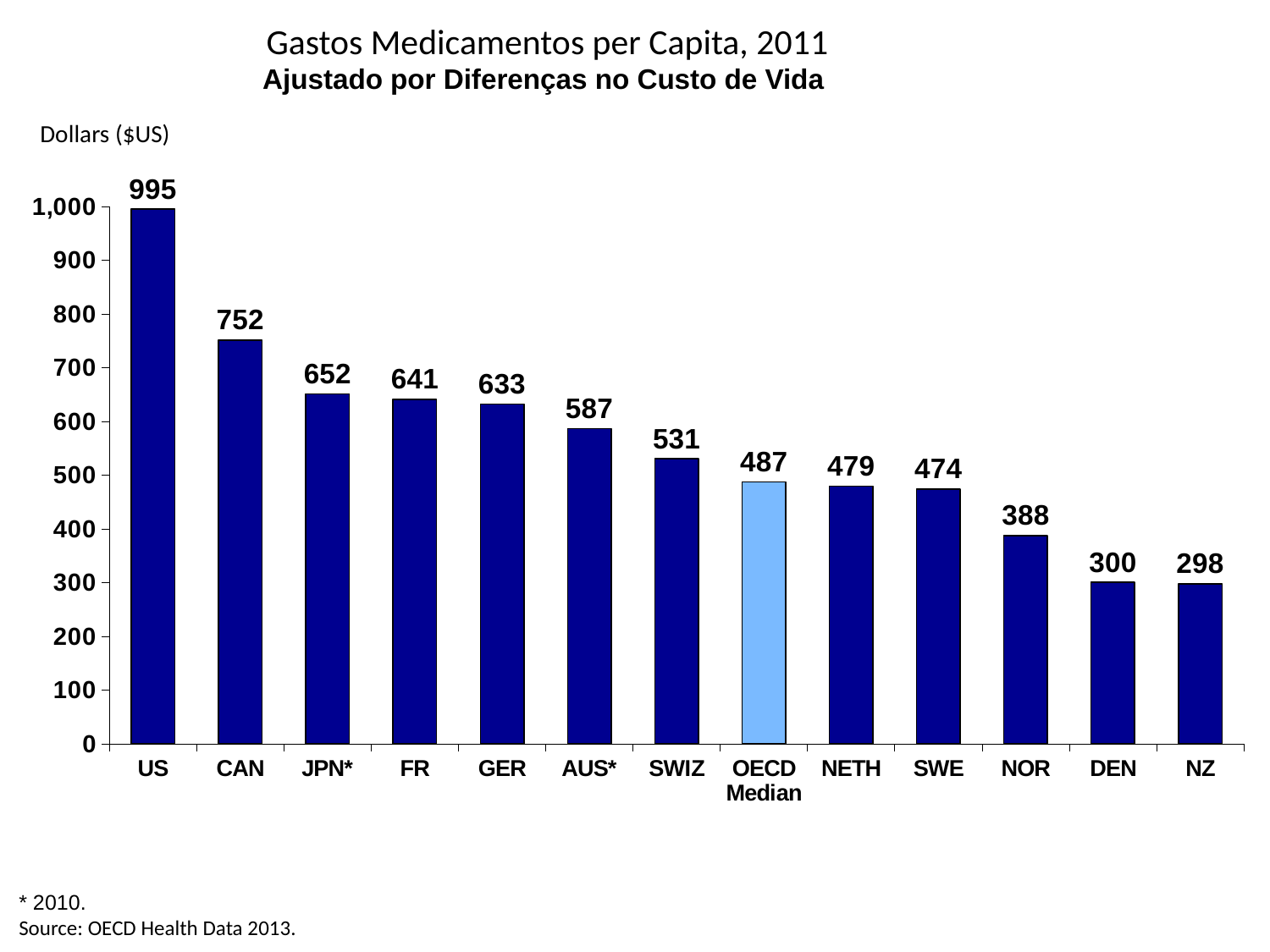
What is the value for NOR? 388 What is the difference between the values for SWIZ and the OECD Median? 44 What is the difference between the values for US and CAN? 243 What is the value for the OECD Median? 487 How many categories are shown on the x axis? 13 What kind of chart is this? bar chart Which bar is shown in a lighter blue colour than the others? OECD Median What is the value for US? 995 Is the value for DEN greater or less than 400? less Which category has the highest value? US Which is larger, the value for JPN* or the value for GER? JPN* Which category has the lowest value? NZ